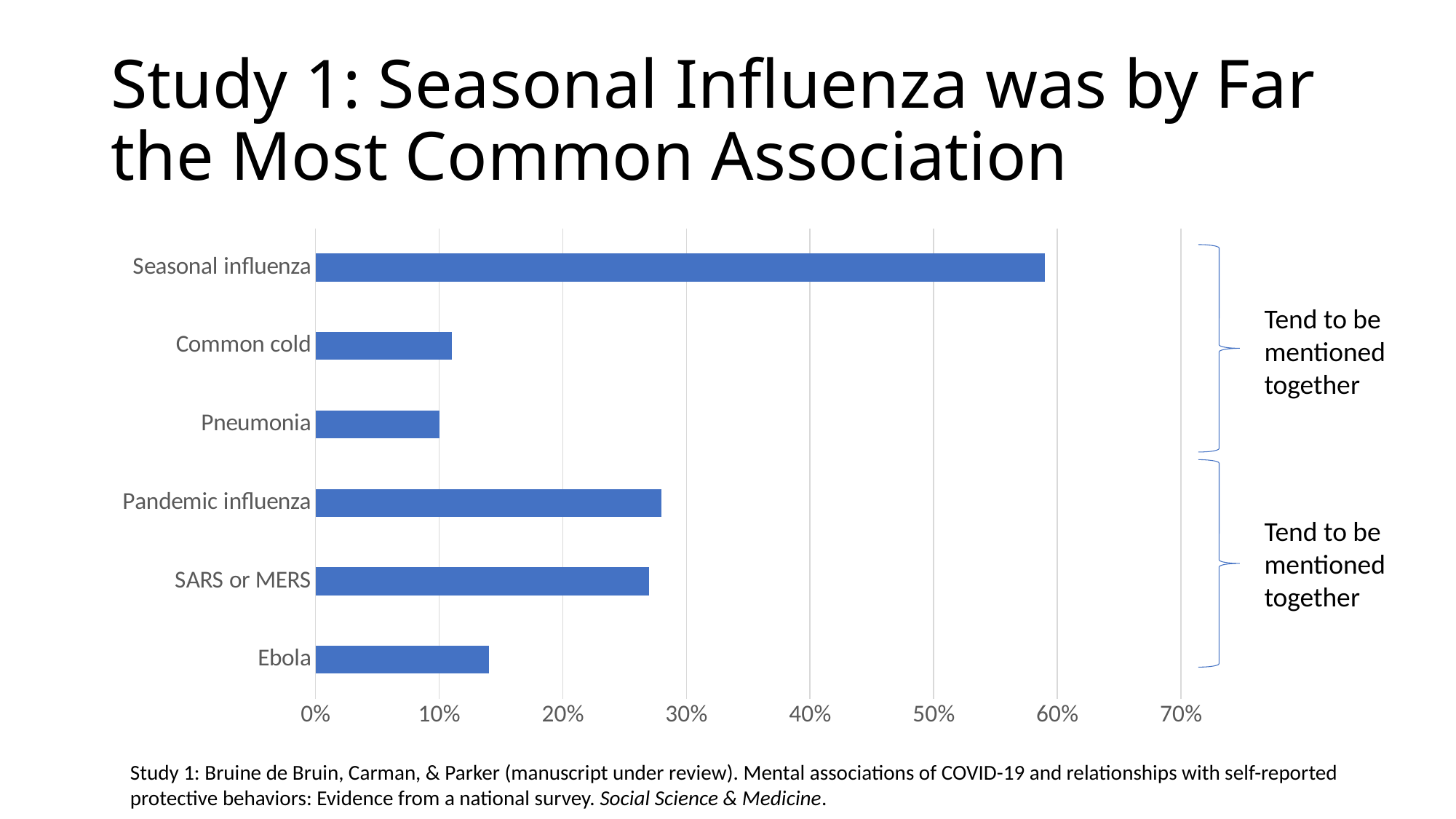
Which is larger, the value for Seasonal influenza or the value for Pandemic influenza? Seasonal influenza Is the value for SARS or MERS greater or less than 30%? less Is the value for Ebola greater or less than 20%? less Which category has the highest value in the chart? Seasonal influenza Which is larger, the value for Ebola or the value for Pandemic influenza? Pandemic influenza What is the highest percentage tick shown on the horizontal axis? 70% Is the value for Common cold greater or less than 20%? less How many categories are plotted in the chart? 6 What kind of chart is shown on the slide? bar chart